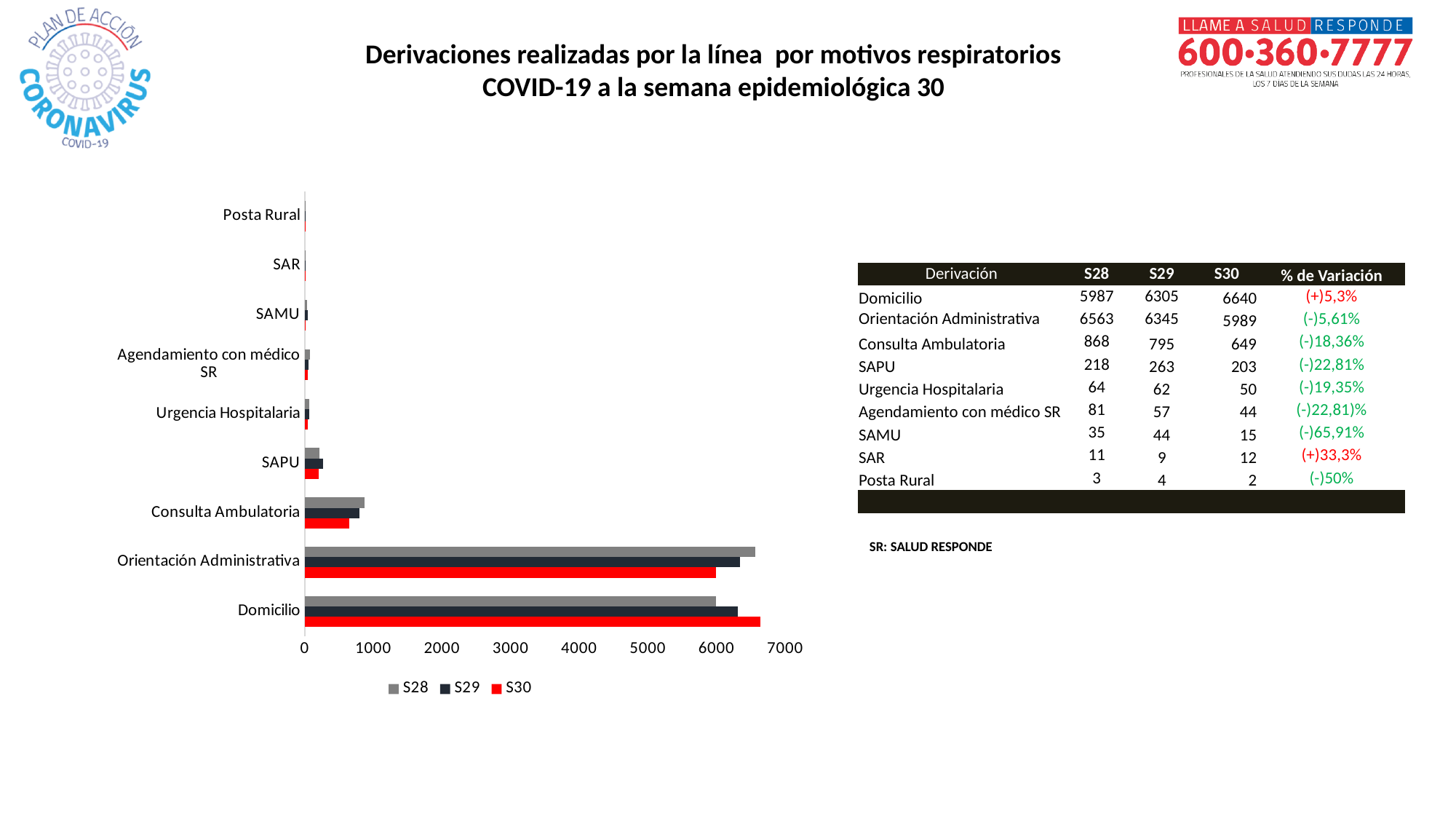
Which category has the lowest S30 value? Posta Rural How many series does the chart legend list? 3 What is the difference between the S28 and S30 values for Orientación Administrativa? 574 What kind of chart is shown on the slide? bar chart Is the S30 value for Domicilio greater or less than 6000? greater Which is larger for SAPU, the S29 value or the S30 value? S29 What is the S30 value for Domicilio? 6640 How many categories are plotted on the chart? 9 Which colour represents the S30 series in the chart? red What is the S28 value for Consulta Ambulatoria? 868 Which category has the highest S30 value? Domicilio Which category has the highest S28 value? Orientación Administrativa